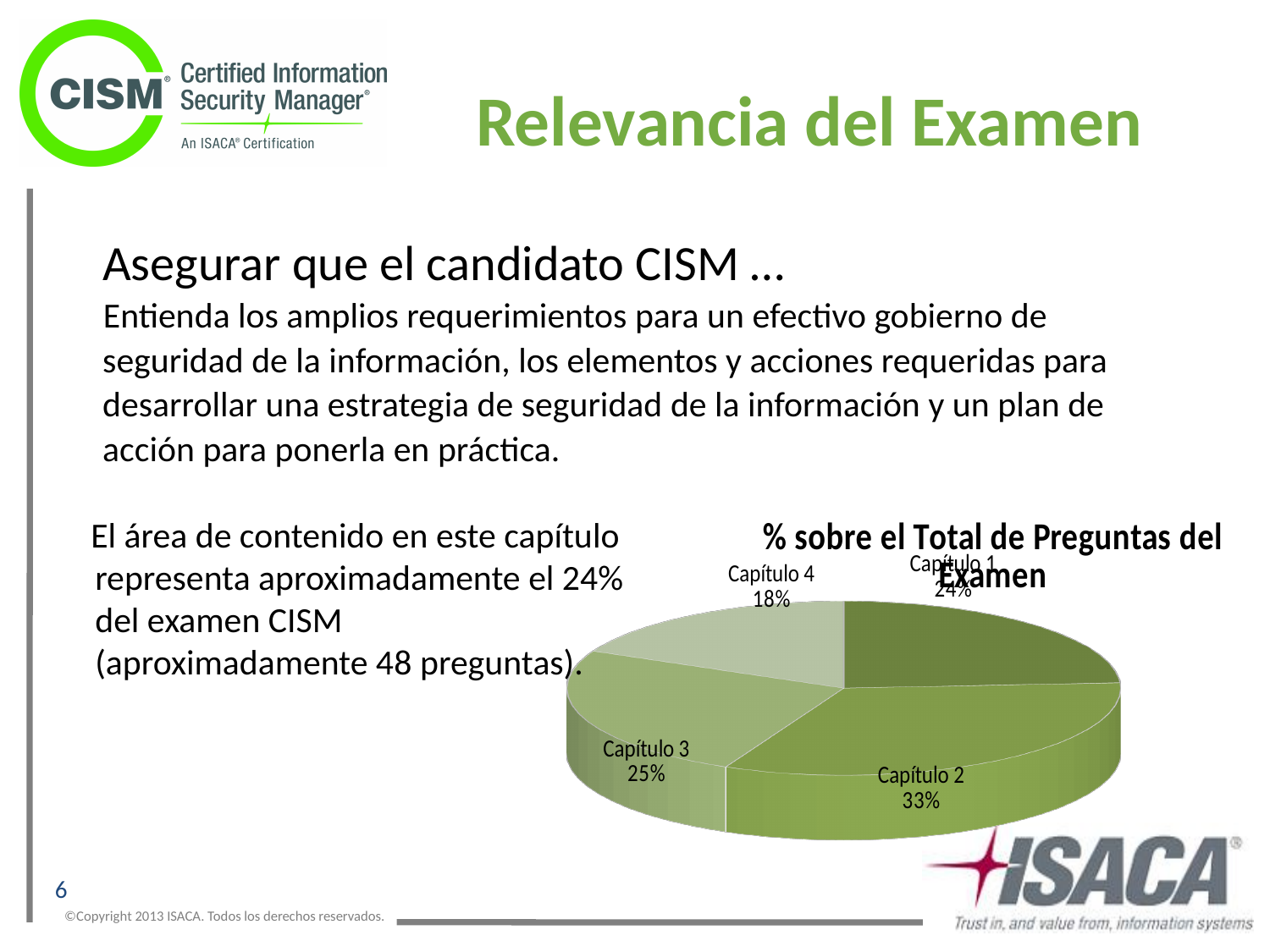
What is the combined share of Capítulo 1 and Capítulo 3? 49% What percentage of the exam questions does Capítulo 4 represent? 18% Which chapter has the smallest share of exam questions? Capítulo 4 What percentage of the exam questions does Capítulo 2 represent? 33% How many slices does the pie chart have? 4 What type of chart is shown on the slide? Pie chart What percentage of the exam questions does Capítulo 3 represent? 25% What is the title of the chart? % sobre el Total de Preguntas del Examen Which chapter has the largest share of exam questions? Capítulo 2 Which has a larger share of exam questions, Capítulo 3 or Capítulo 4? Capítulo 3 What is the difference in percentage points between Capítulo 2 and Capítulo 4? 15 What percentage of the exam questions does Capítulo 1 represent? 24%